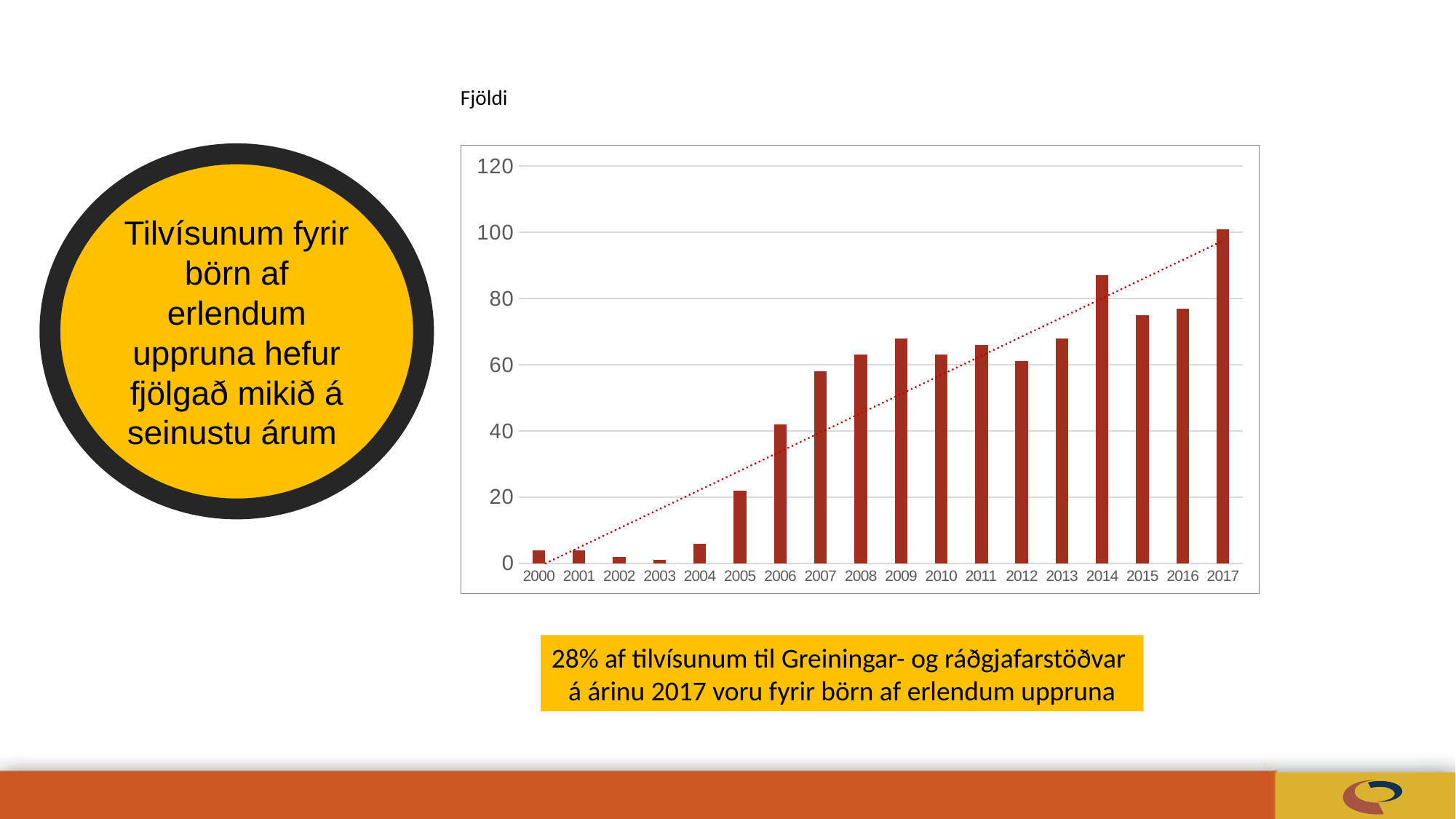
Is the value for 2017 greater or less than 80? greater What kind of chart is shown on the slide? Bar chart Is the value for 2000 greater or less than 20? less Which year has the larger value, 2005 or 2006? 2006 Do the values generally rise or fall from 2000 to 2017? Rise Is the value for 2014 greater or less than 80? greater What is the title of the chart? Fjöldi Which year has the larger value, 2014 or 2015? 2014 Which year has the highest bar in the chart? 2017 How many years are shown on the x axis of the chart? 18